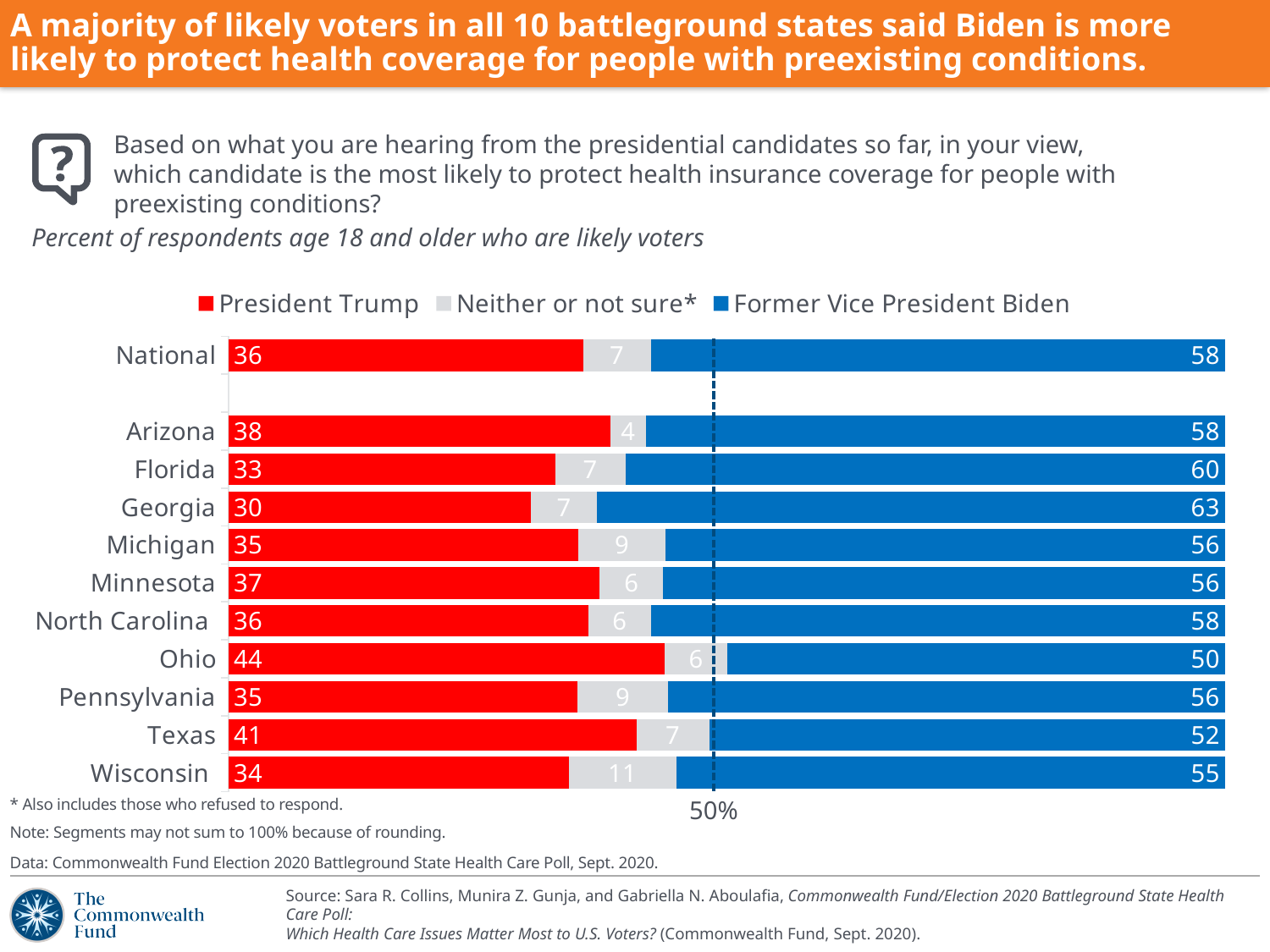
What kind of chart is shown on the slide? Stacked bar chart Is the value for President Trump larger in Arizona or in Florida? Arizona What is the total of the three segments for the National bar? 101 What is the difference between the Biden and Trump values in Texas? 11 Which state has the highest value for President Trump? Ohio What is the value for Neither or not sure in Wisconsin? 11 Which state has the lowest value for Former Vice President Biden? Ohio What percentage of likely voters in Georgia said Former Vice President Biden is more likely to protect health coverage for people with preexisting conditions? 63 How many categories (including National) are plotted on the chart? 11 What is the value for President Trump in Ohio? 44 Which state has the highest value for Former Vice President Biden? Georgia How many series does the legend list? 3